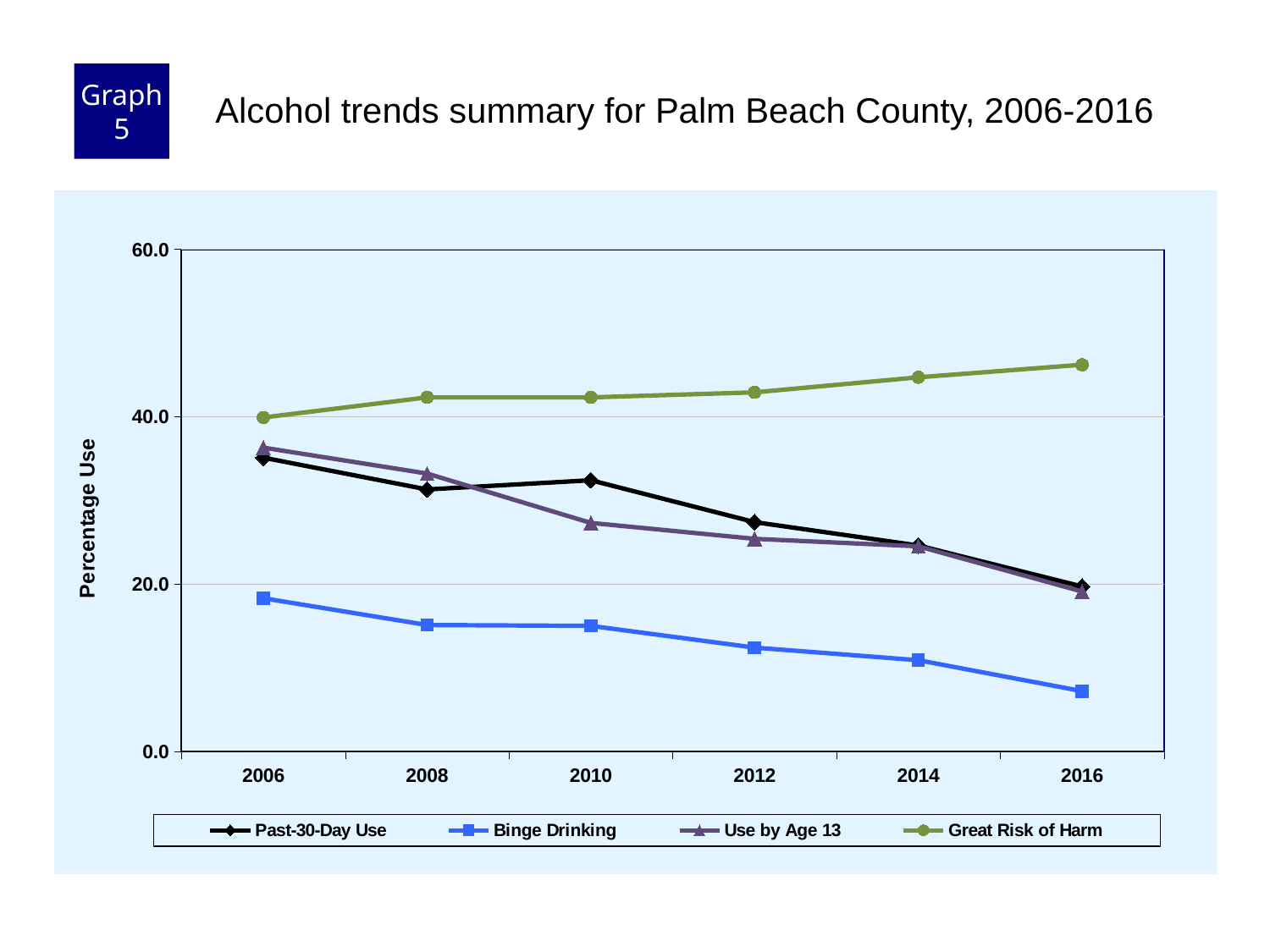
Does the Binge Drinking line rise or fall from 2006 to 2016? Falls How many series does the legend list? 4 What kind of chart is shown on the slide? Line chart Is the value for Binge Drinking in 2016 greater or less than 20.0? less What is the label on the y axis? Percentage Use Does the Great Risk of Harm line rise or fall from 2006 to 2016? Rises Which series has the highest value in 2016? Great Risk of Harm How many years are plotted along the x axis? 6 Which series has the lowest value in 2006? Binge Drinking In 2010, which is larger: Past-30-Day Use or Use by Age 13? Past-30-Day Use Is the value for Great Risk of Harm in 2016 greater or less than 40.0? greater Is the value for Past-30-Day Use in 2006 greater or less than 40.0? less